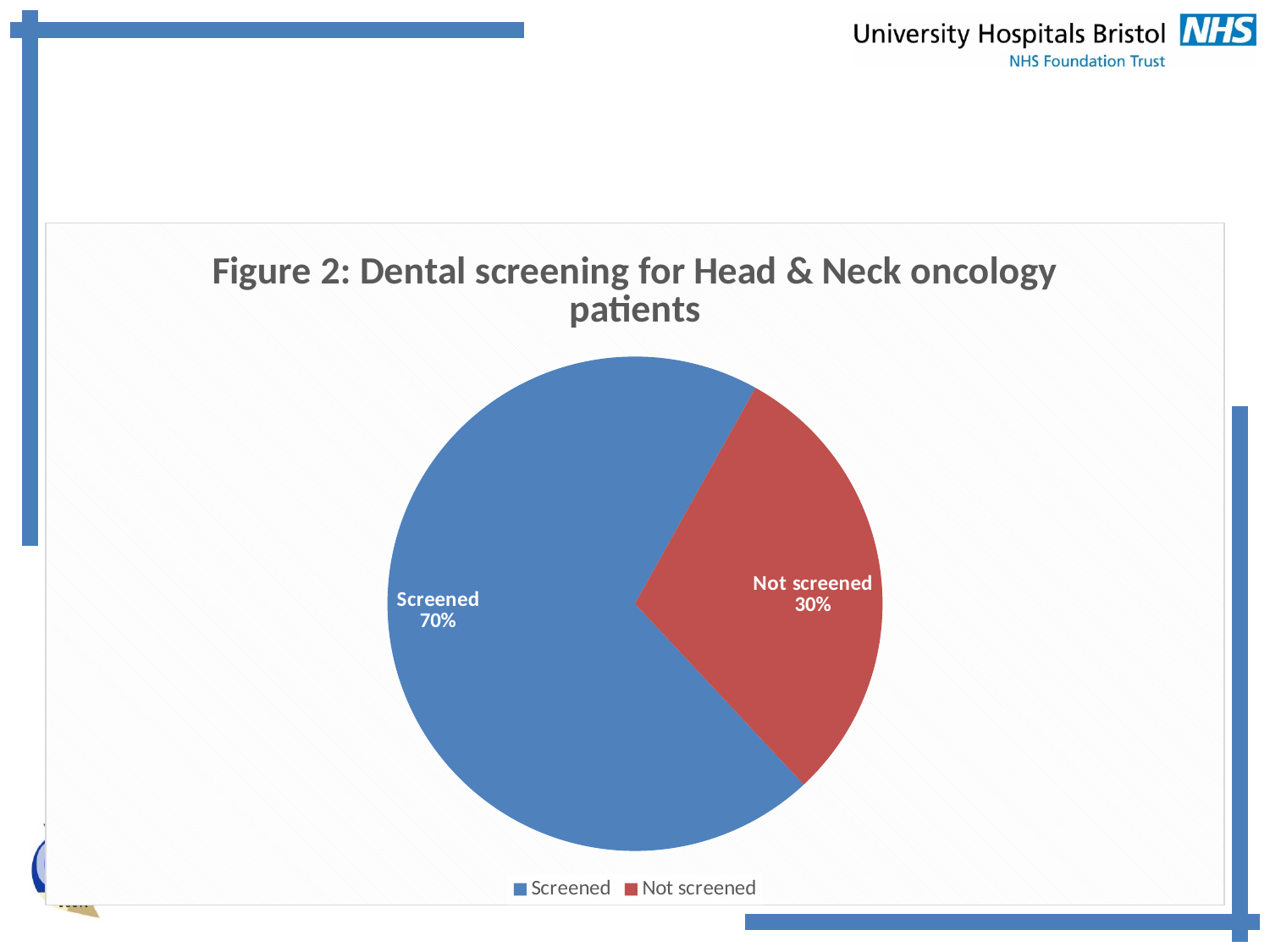
What colour is the Not screened slice? red Which is larger: the Screened slice or the Not screened slice? Screened What percentage of patients were not screened? 30% Which slice of the pie is the smallest? Not screened What type of chart is shown on the slide? pie chart How many slices does the pie chart have? 2 What is the title of the chart? Figure 2: Dental screening for Head & Neck oncology patients What share of the pie does the Not screened slice represent? 30% Which slice of the pie is the largest? Screened What is the difference in percentage points between the Screened and Not screened slices? 40 How many entries does the legend list? 2 What percentage of Head & Neck oncology patients were screened? 70%